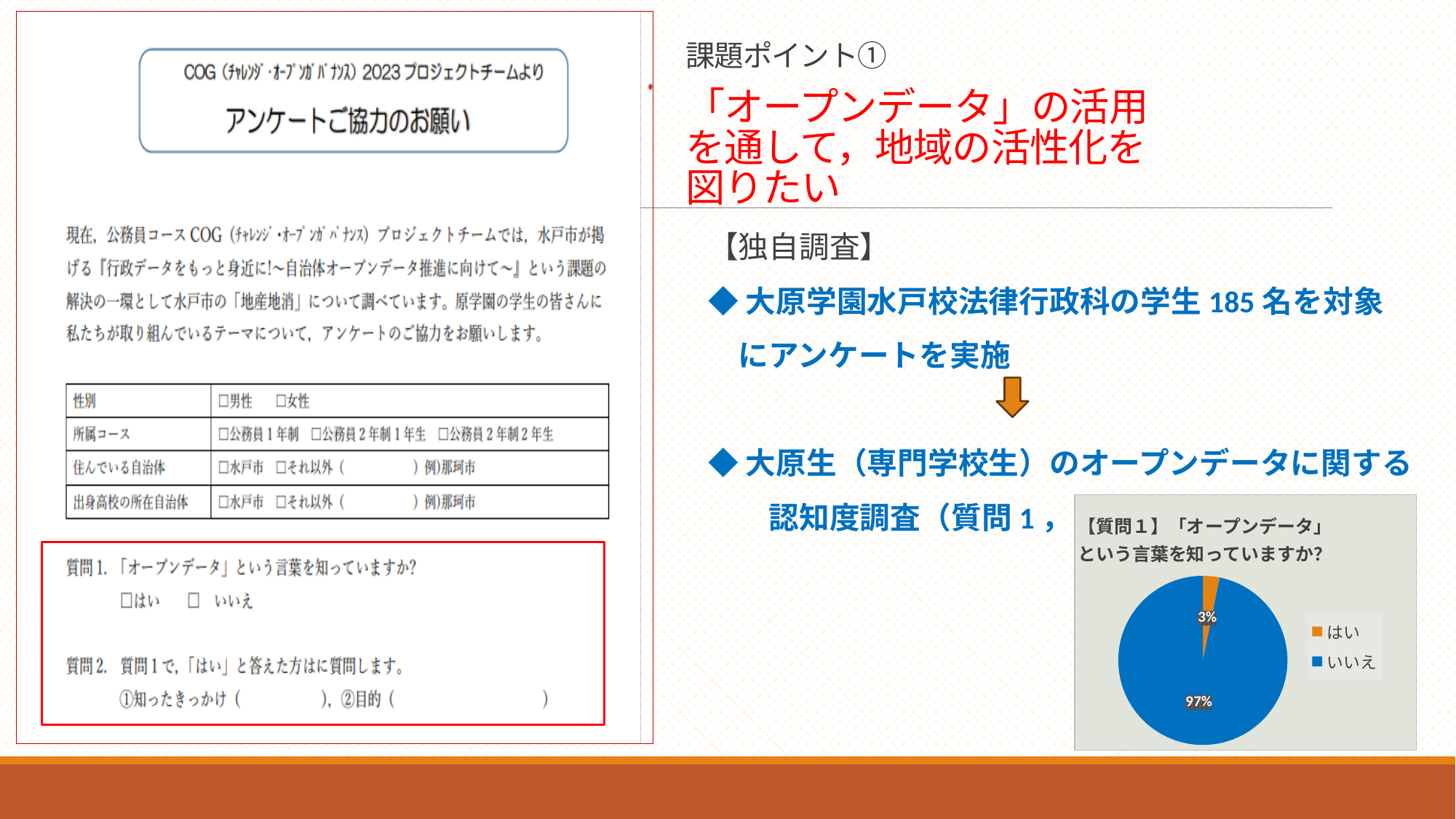
Which slice of the pie chart is the smallest? はい Which slice of the pie chart is the largest? いいえ What colour is the 「いいえ」 slice in the pie chart? blue What share of the pie does 「いいえ」 represent? 97% How many slices does the pie chart have? 2 What share of the pie does 「はい」 represent? 3% Which is larger, the 「はい」 slice or the 「いいえ」 slice? いいえ What is the difference in percentage points between the 「いいえ」 and 「はい」 slices? 94 What kind of chart is shown on the slide? pie chart What is the title of the pie chart? 【質問１】「オープンデータ」という言葉を知っていますか? How many entries does the pie chart's legend list? 2